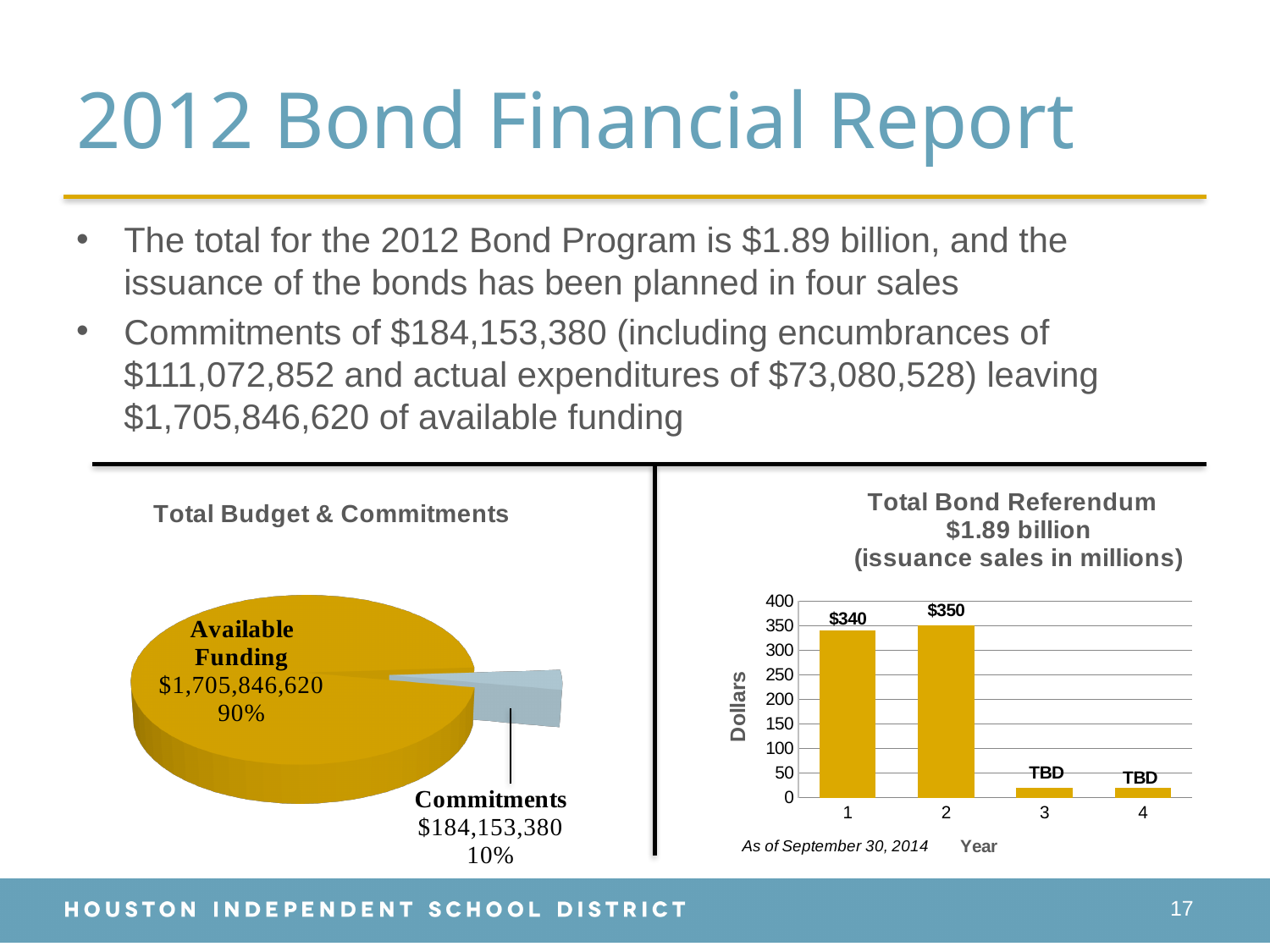
In the Total Budget & Commitments chart, what is the value for Available Funding? $1,705,846,620 In the Total Bond Referendum chart, what is the value for Year 2? $350 How many slices does the Total Budget & Commitments pie chart have? 2 In the Total Budget & Commitments chart, what is the value for Commitments? $184,153,380 In the Total Bond Referendum chart, what is the value for Year 1? $340 In the Total Bond Referendum chart, what is the difference between Year 2 and Year 1? $10 In the Total Budget & Commitments chart, what share of the pie is Available Funding? 90% In the Total Bond Referendum chart, what label is shown for Years 3 and 4? TBD In the Total Bond Referendum chart, what is the y-axis label? Dollars What kind of chart is the Total Budget & Commitments chart? Pie chart What kind of chart is the Total Bond Referendum chart? Bar chart In the Total Budget & Commitments chart, what share of the pie is Commitments? 10%